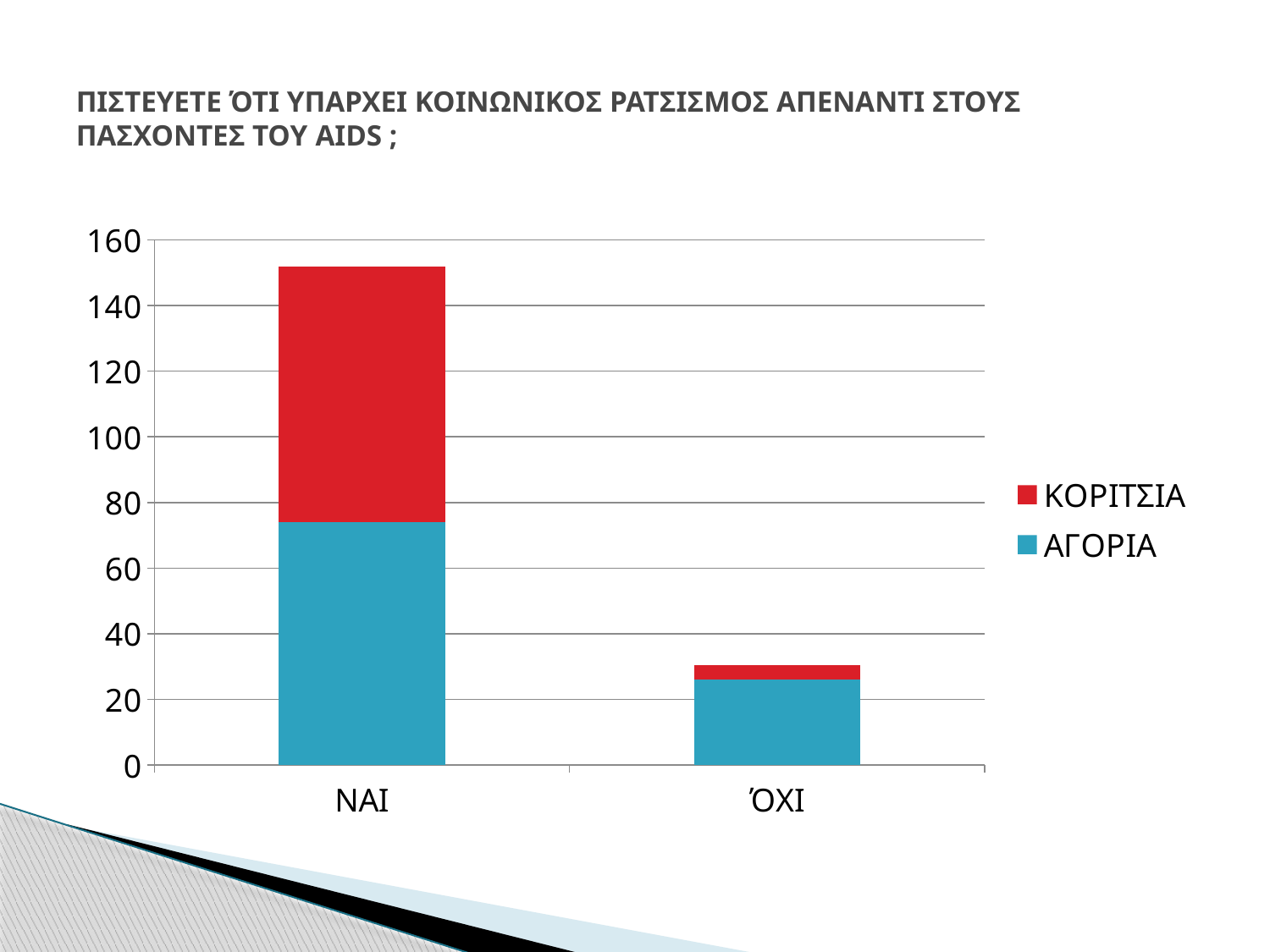
Which series is shown in blue? ΑΓΟΡΙΑ Which colour represents the ΚΟΡΙΤΣΙΑ series? Red What kind of chart is shown on the slide? Stacked bar chart Which category has the shortest stacked bar? ΌΧΙ Which category has the tallest stacked bar? ΝΑΙ Is the total stacked value for ΝΑΙ greater or less than 140? greater How many categories are shown on the x axis? 2 Is the ΑΓΟΡΙΑ value for ΝΑΙ greater or less than 60? greater How many series does the legend list? 2 Is the ΑΓΟΡΙΑ value for ΌΧΙ greater or less than 20? greater Within the ΌΧΙ bar, which series has the larger value, ΑΓΟΡΙΑ or ΚΟΡΙΤΣΙΑ? ΑΓΟΡΙΑ